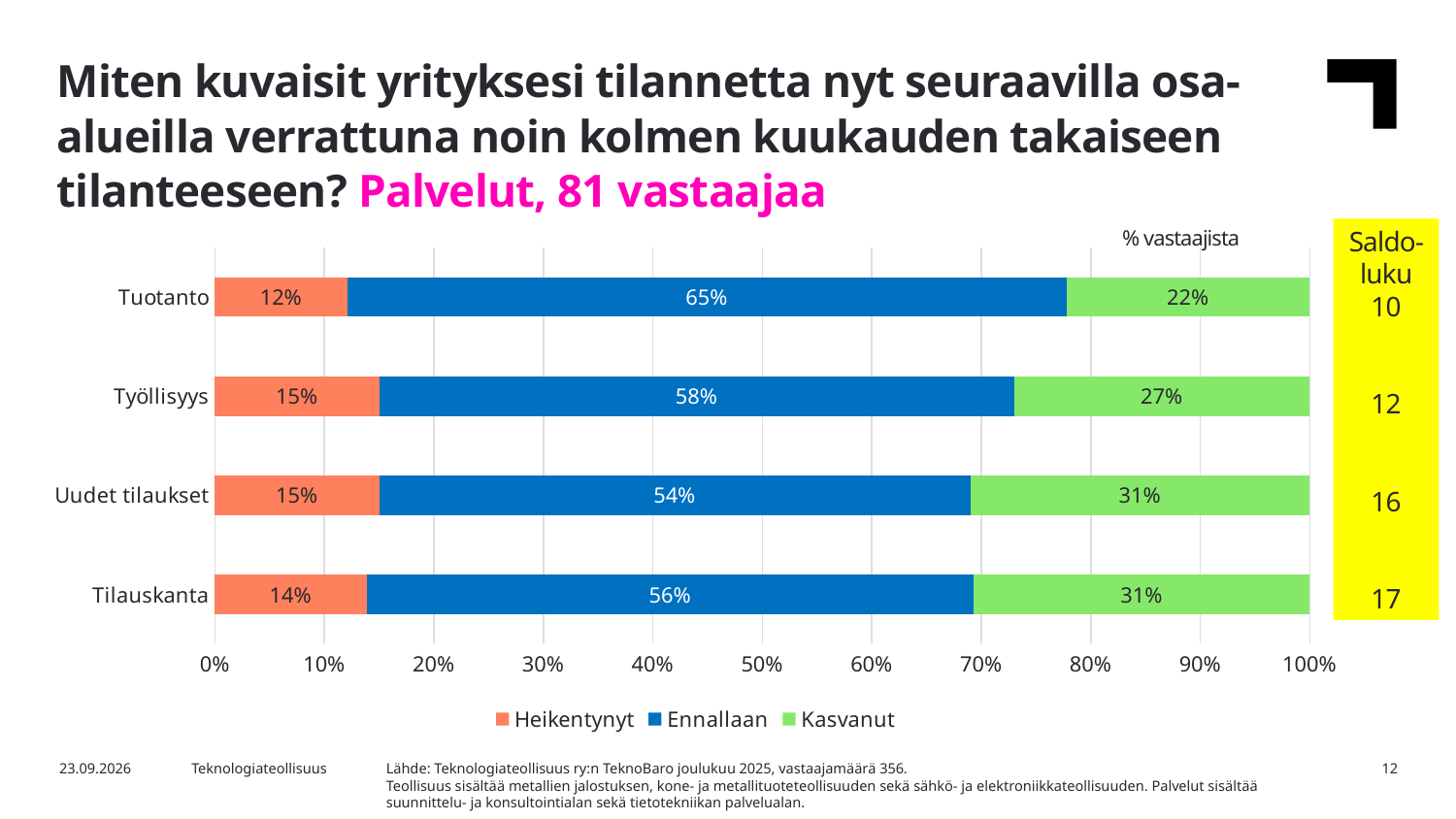
What are the three legend entries of the chart? Heikentynyt, Ennallaan, Kasvanut Which category has the highest Ennallaan share? Tuotanto What percentage of respondents answered Ennallaan for Tuotanto? 65% How many categories are shown on the chart? 4 What kind of chart is shown on the slide? Stacked bar chart What is the Heikentynyt value for Tilauskanta? 14% What is the Ennallaan value for Työllisyys? 58% What is the Kasvanut value for Uudet tilaukset? 31% How many series does the legend list? 3 Which category has the lowest Kasvanut share? Tuotanto What is the difference between the Kasvanut values for Työllisyys and Tuotanto? 5% Which is larger: the Ennallaan value for Uudet tilaukset or for Tilauskanta? Tilauskanta